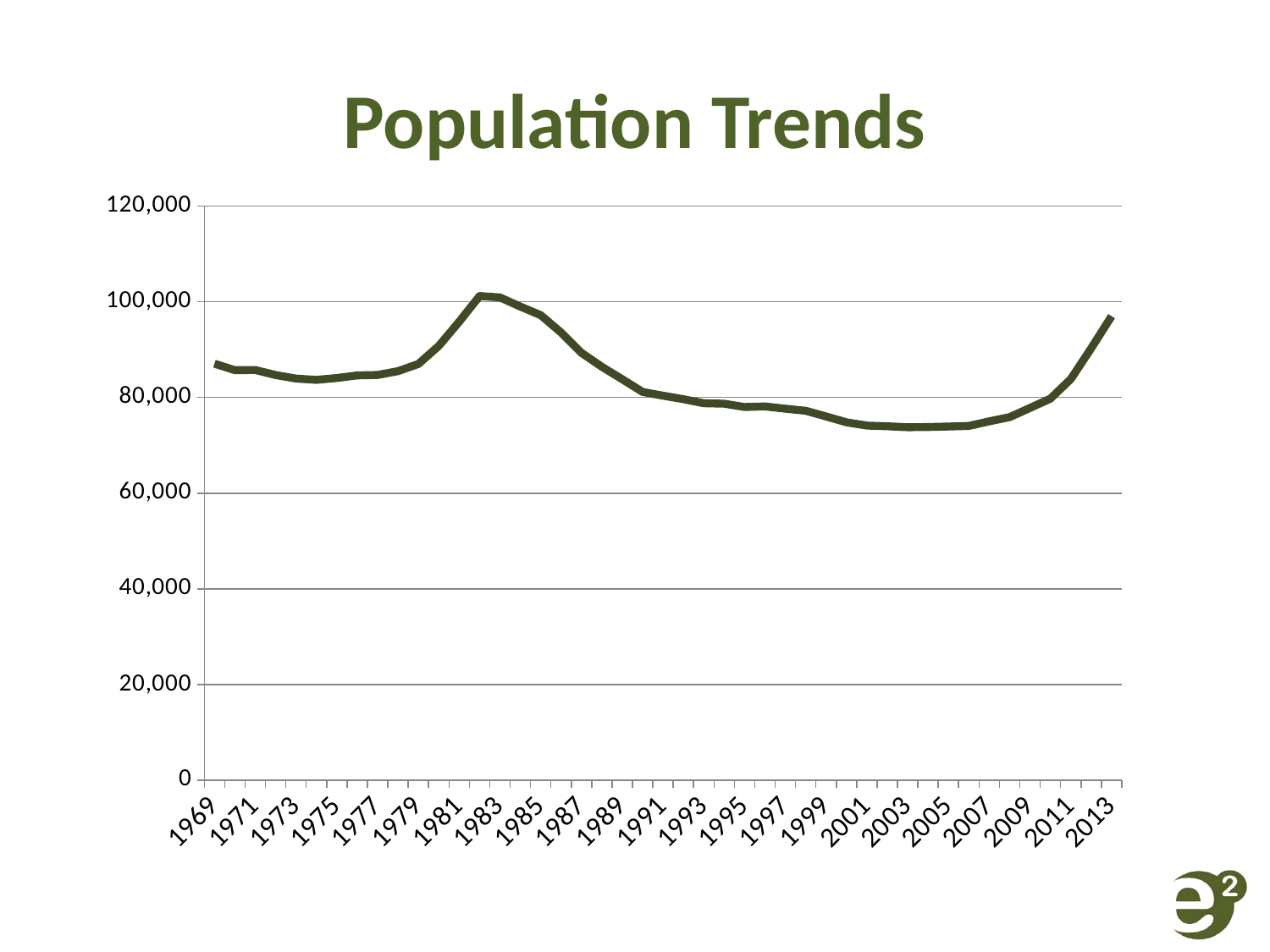
Which year has the larger value, 1983 or 2013? 1983 Is the value for 1969 greater or less than 80,000? greater Is the value for 2003 greater or less than 80,000? less What is the title of the chart? Population Trends Is the value for 1985 greater or less than 100,000? less What kind of chart is shown on the slide? line chart Does the population rise or fall between 2009 and 2013? rise How many lines are plotted on the chart? 1 Does the population rise or fall between 1983 and 2003? fall